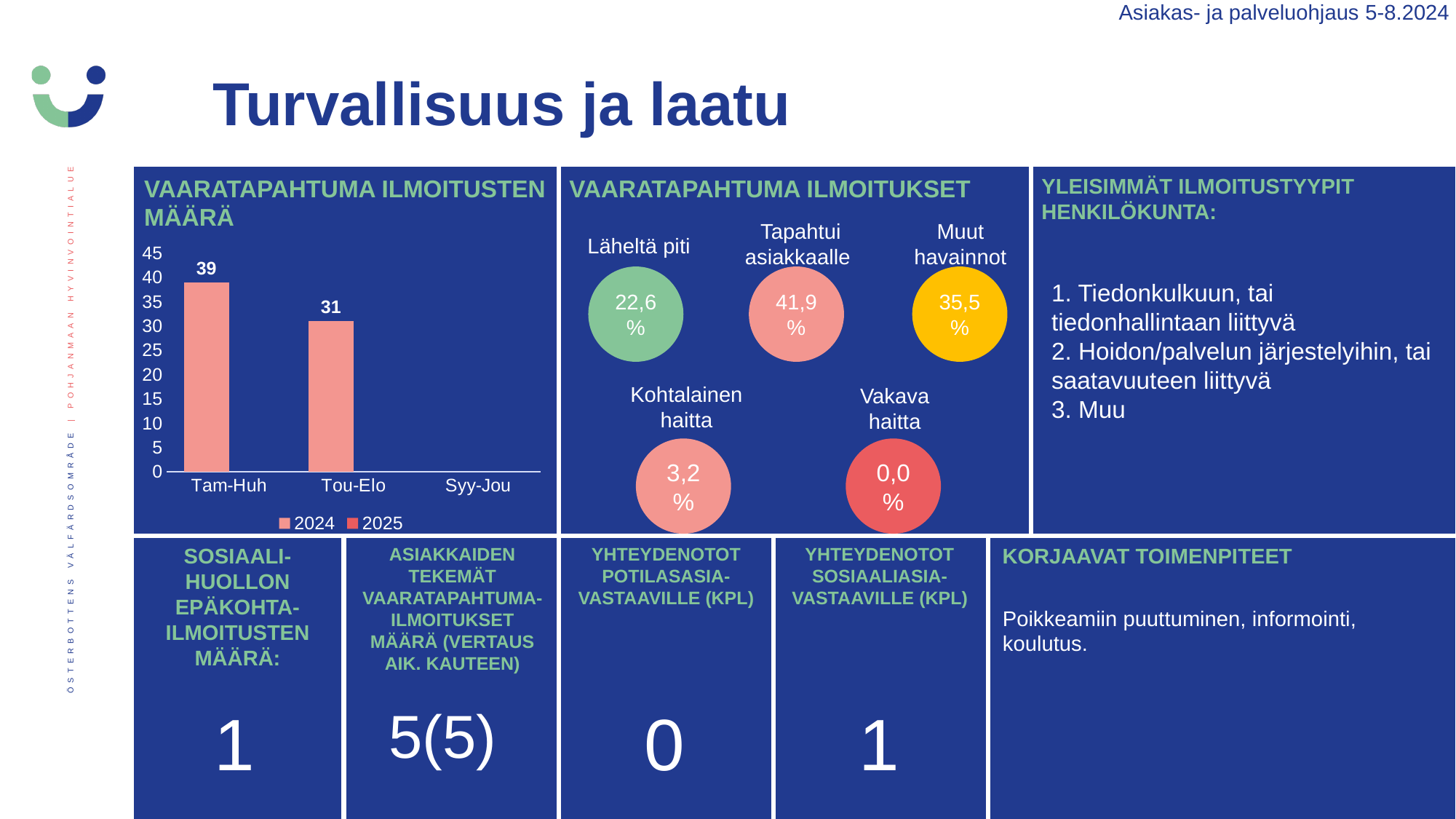
In the chart 'VAARATAPAHTUMA ILMOITUSTEN MÄÄRÄ', which is larger, the value for Tam-Huh or the value for Tou-Elo? Tam-Huh What type of chart is 'VAARATAPAHTUMA ILMOITUSTEN MÄÄRÄ'? bar chart In the chart 'VAARATAPAHTUMA ILMOITUSTEN MÄÄRÄ', what is the value for Tou-Elo? 31 In the chart 'VAARATAPAHTUMA ILMOITUSTEN MÄÄRÄ', how many series does the legend list? 2 In the chart 'VAARATAPAHTUMA ILMOITUSTEN MÄÄRÄ', do the values rise or fall from Tam-Huh to Tou-Elo? fall In the chart 'VAARATAPAHTUMA ILMOITUSTEN MÄÄRÄ', what is the difference between the values for Tam-Huh and Tou-Elo? 8 In the chart 'VAARATAPAHTUMA ILMOITUSTEN MÄÄRÄ', what is the value for Tam-Huh? 39 In the chart 'VAARATAPAHTUMA ILMOITUSTEN MÄÄRÄ', what is the highest value shown on the y axis? 45 In the chart 'VAARATAPAHTUMA ILMOITUSTEN MÄÄRÄ', is the value for Tou-Elo greater or less than 35? less In the chart 'VAARATAPAHTUMA ILMOITUSTEN MÄÄRÄ', how many categories are shown on the x axis? 3 In the chart 'VAARATAPAHTUMA ILMOITUSTEN MÄÄRÄ', which category has the highest bar? Tam-Huh In the chart 'VAARATAPAHTUMA ILMOITUSTEN MÄÄRÄ', which category has no bar plotted? Syy-Jou